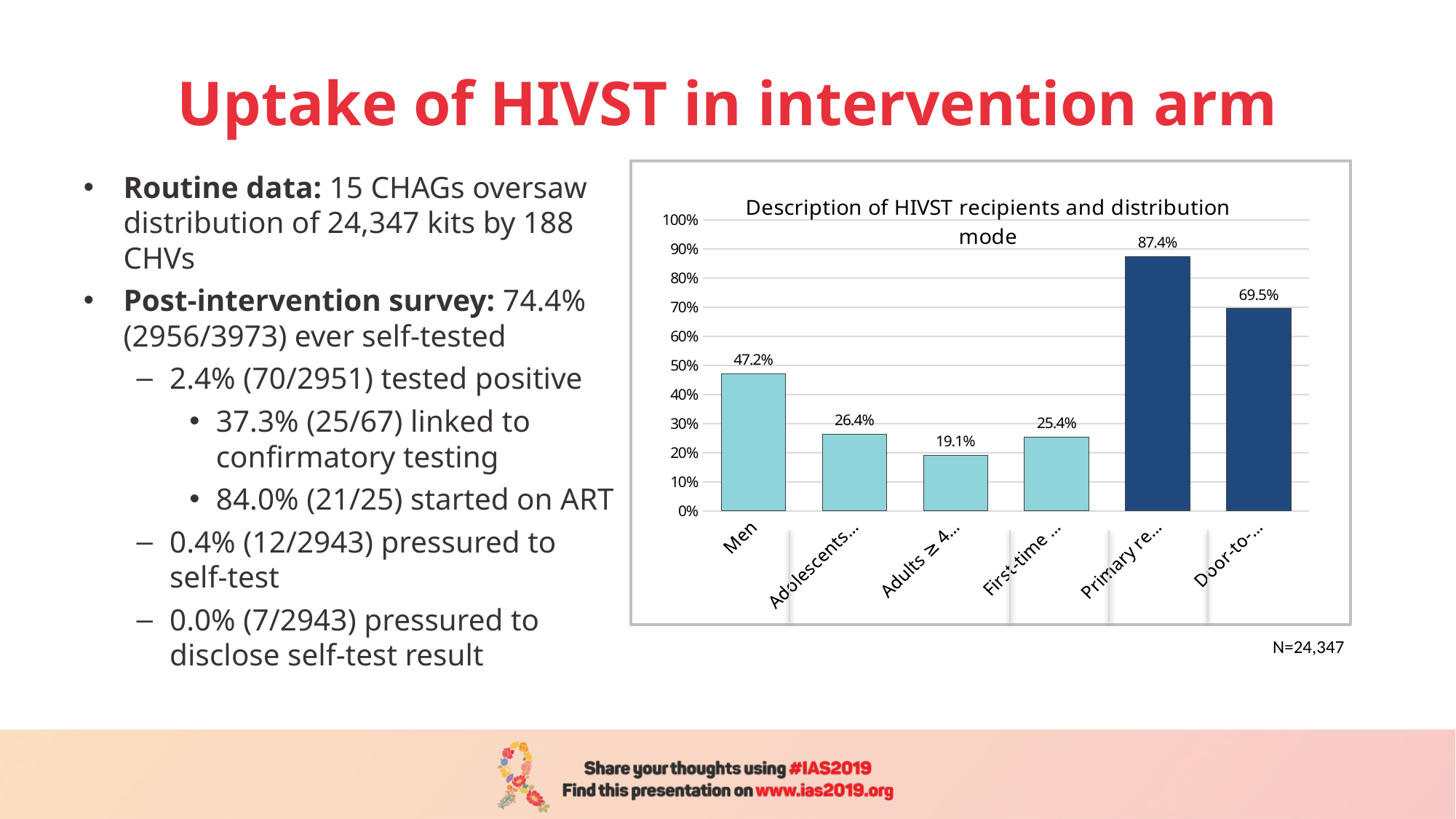
What is the value for Men in the chart? 47.2% What is the title of the chart? Description of HIVST recipients and distribution mode Which is larger, the value for Men or the value for 'First-time …'? Men What kind of chart is shown on the slide? Bar chart How many categories are shown in the chart? 6 What is the difference between the values for 'Primary re…' and 'Door-to-…'? 17.9% What is the value for the category labelled 'Adolescents…' in the chart? 26.4% Which category has the highest value in the chart? Primary re… What is the value for the category labelled 'Door-to-…' in the chart? 69.5% Which category has the lowest value in the chart? Adults ≥ 4… Is the value for Men greater or less than 50%? less What is the value for the category labelled 'Primary re…' in the chart? 87.4%